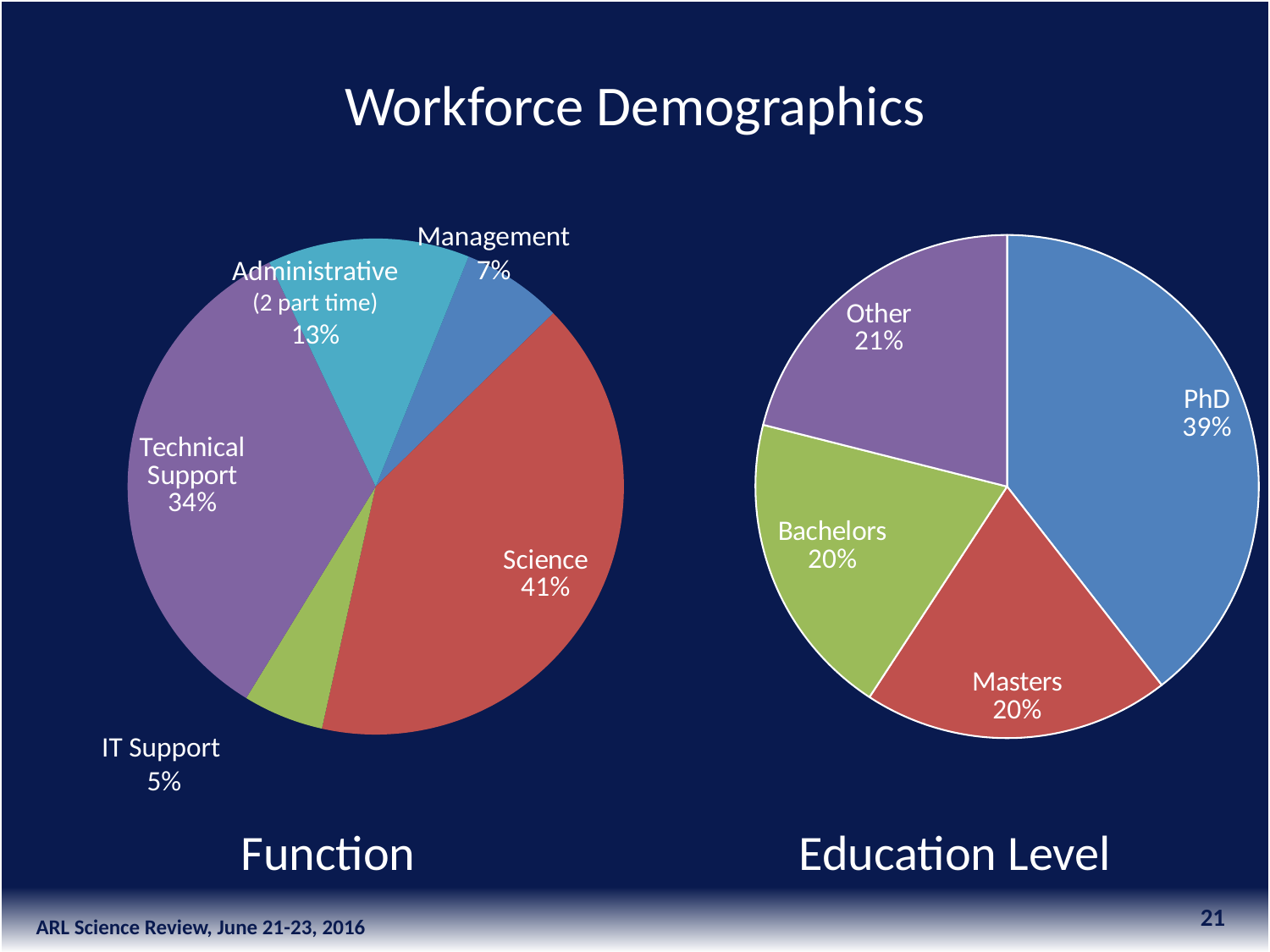
In the Function pie chart, which category has the largest share? Science What type of chart is used for the Education Level chart? Pie chart In the Education Level pie chart, which category has the largest share? PhD In the Education Level pie chart, what share holds a PhD? 39% In the Function pie chart, what share of the workforce is Science? 41% In the Education Level pie chart, what is the difference between the PhD and Bachelors shares? 19% In the Function pie chart, what share is Technical Support? 34% In the Education Level pie chart, what share is Other? 21% In the Function pie chart, which category has the smallest share? IT Support In the Function pie chart, what is the difference between the Science and Technical Support shares? 7% In the Function pie chart, how many categories are shown? 5 In the Education Level pie chart, which is larger, Other or Masters? Other